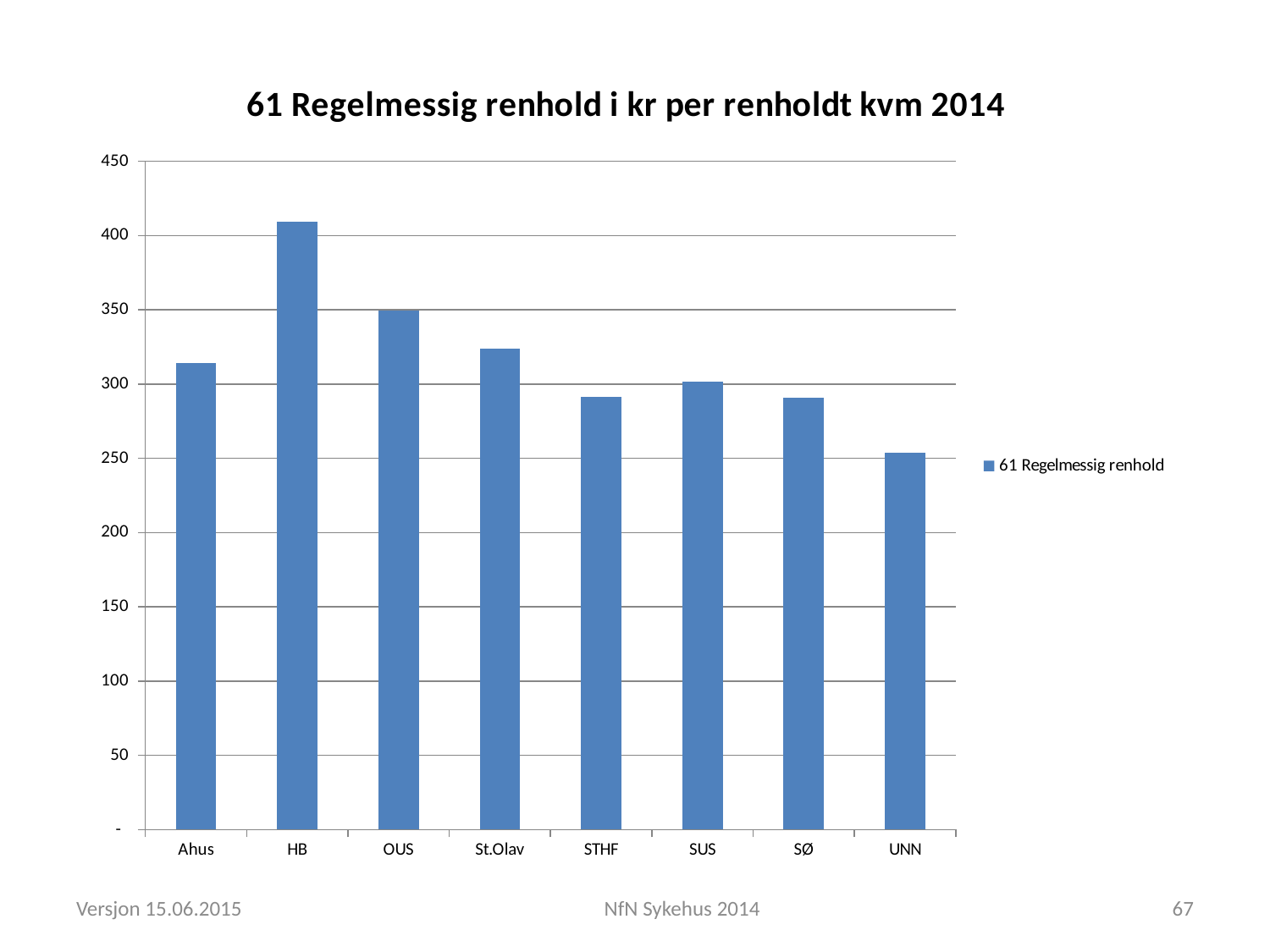
How many series does the legend list? 1 Is the value for HB greater or less than 400? greater Which is larger, the value for HB or the value for OUS? HB Is the value for UNN greater or less than 300? less Is the value for St.Olav greater or less than 350? less How many categories are shown on the x axis? 8 What kind of chart is shown on the slide? bar chart Which category has the highest value? HB Which is larger, the value for Ahus or the value for UNN? Ahus Which category has the lowest value? UNN